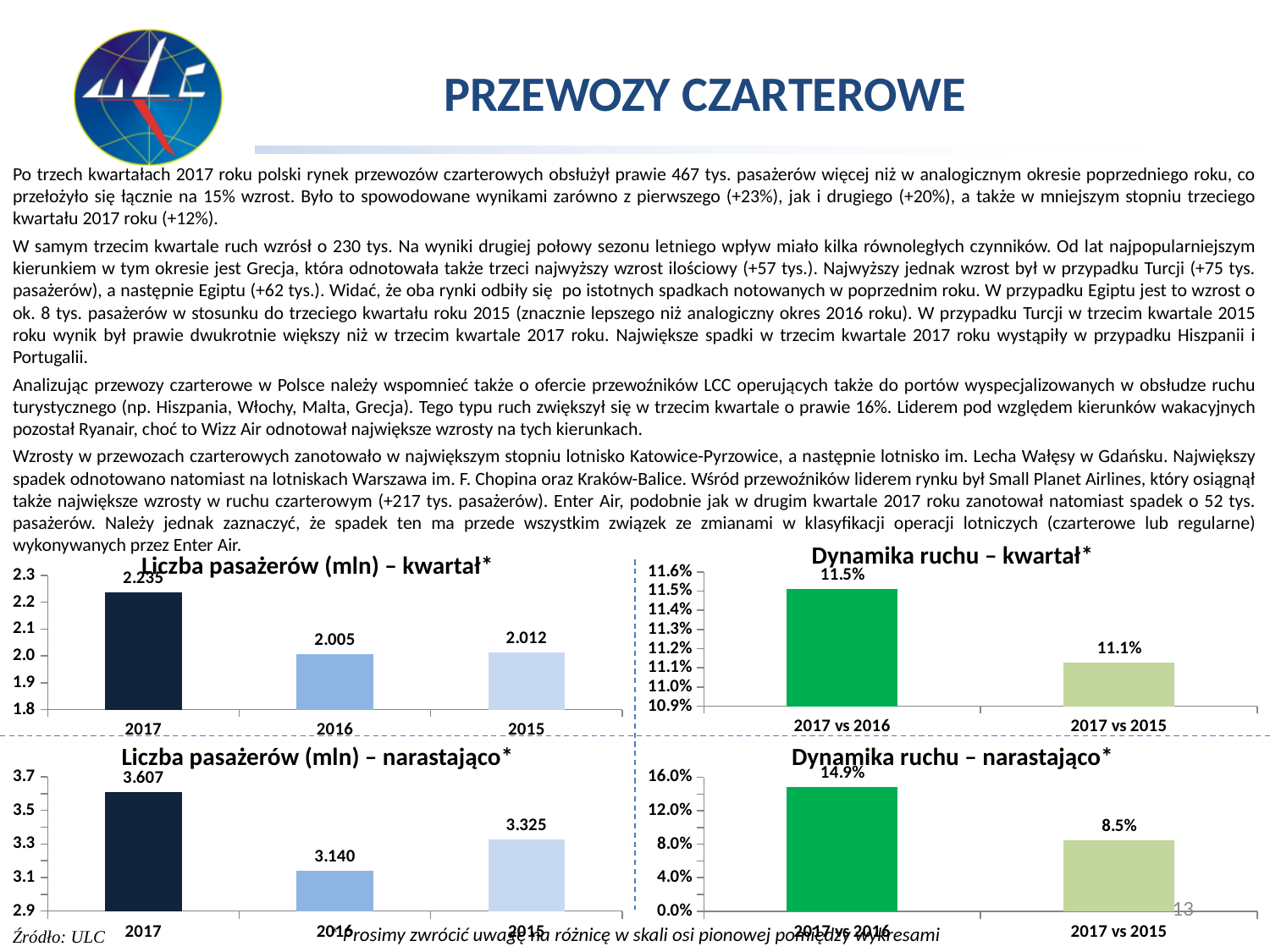
In the chart 'Liczba pasażerów (mln) – kwartał*', what is the value for 2017? 2.235 In the chart 'Dynamika ruchu – kwartał*', which category has the higher value? 2017 vs 2016 In the chart 'Dynamika ruchu – kwartał*', what is the value for 2017 vs 2015? 11.1% In the chart 'Liczba pasażerów (mln) – narastająco*', which year has the highest value? 2017 In the chart 'Dynamika ruchu – narastająco*', what is the difference between the 2017 vs 2016 and 2017 vs 2015 values? 6.4% In the chart 'Liczba pasażerów (mln) – kwartał*', what is the difference between the 2017 and 2016 values? 0.230 In the chart 'Dynamika ruchu – narastająco*', what is the value for 2017 vs 2016? 14.9% In the chart 'Liczba pasażerów (mln) – kwartał*', which year has the lowest value? 2016 In the chart 'Liczba pasażerów (mln) – narastająco*', what is the value for 2015? 3.325 In the chart 'Liczba pasażerów (mln) – narastająco*', is the value for 2016 larger or smaller than the value for 2015? smaller What type of chart is 'Dynamika ruchu – kwartał*'? bar chart How many bars does the chart 'Liczba pasażerów (mln) – kwartał*' show? 3